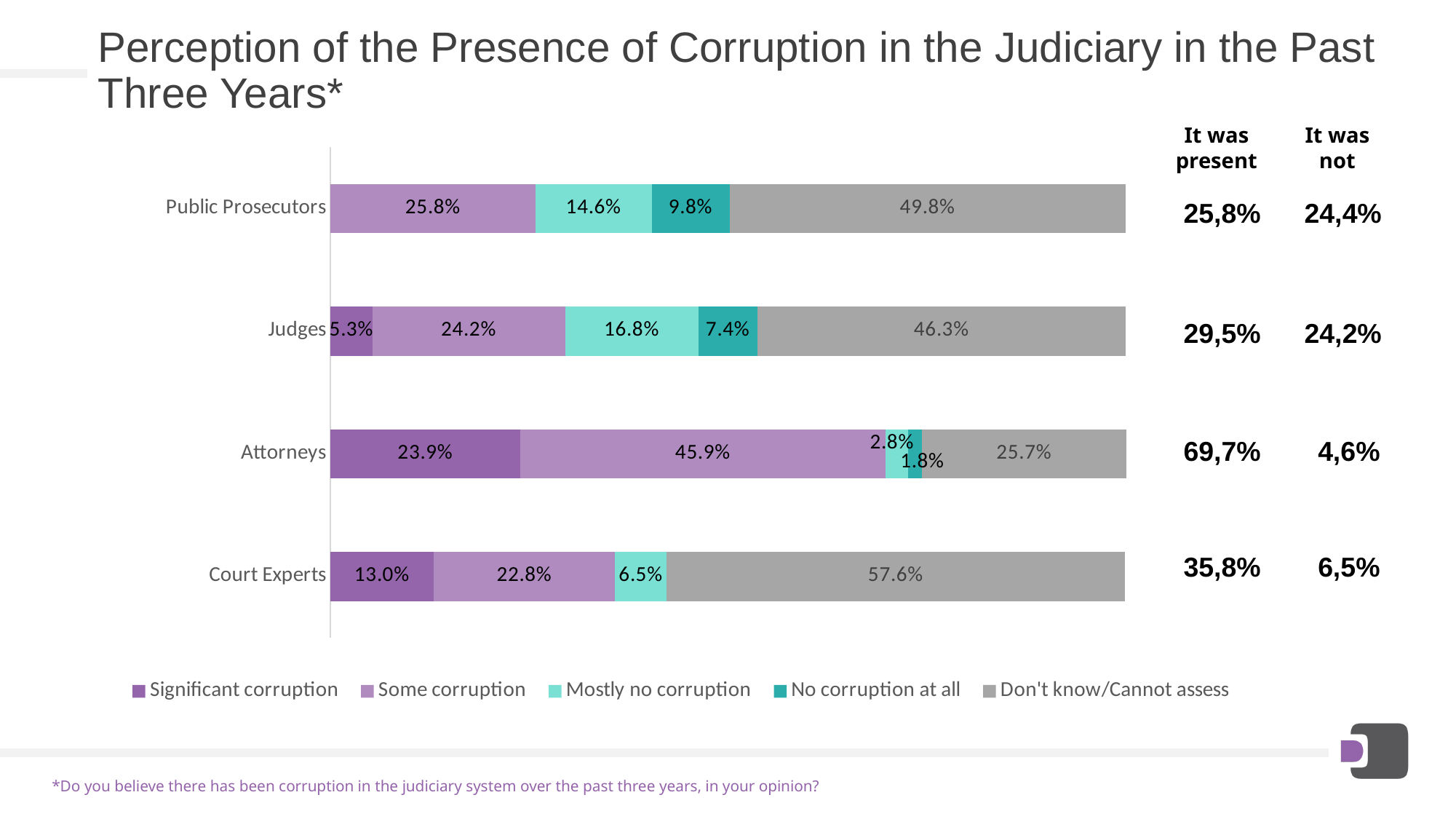
What is the "No corruption at all" value for Public Prosecutors? 9.8% Which is larger: the "Some corruption" value for Public Prosecutors or for Judges? Public Prosecutors How many respondent groups are shown on the chart? 4 What share of Judges reported "Significant corruption"? 5.3% How many series does the legend list? 5 What percentage of Attorneys reported "Some corruption"? 45.9% What is the "Don't know/Cannot assess" value for Court Experts? 57.6% Which group has the highest "Don't know/Cannot assess" share? Court Experts Which group has the highest "Some corruption" share? Attorneys What type of chart is shown on the slide? Stacked bar chart Which group has the lowest "Don't know/Cannot assess" share? Attorneys What is the difference between the "Significant corruption" values for Attorneys and Court Experts? 10.9 percentage points